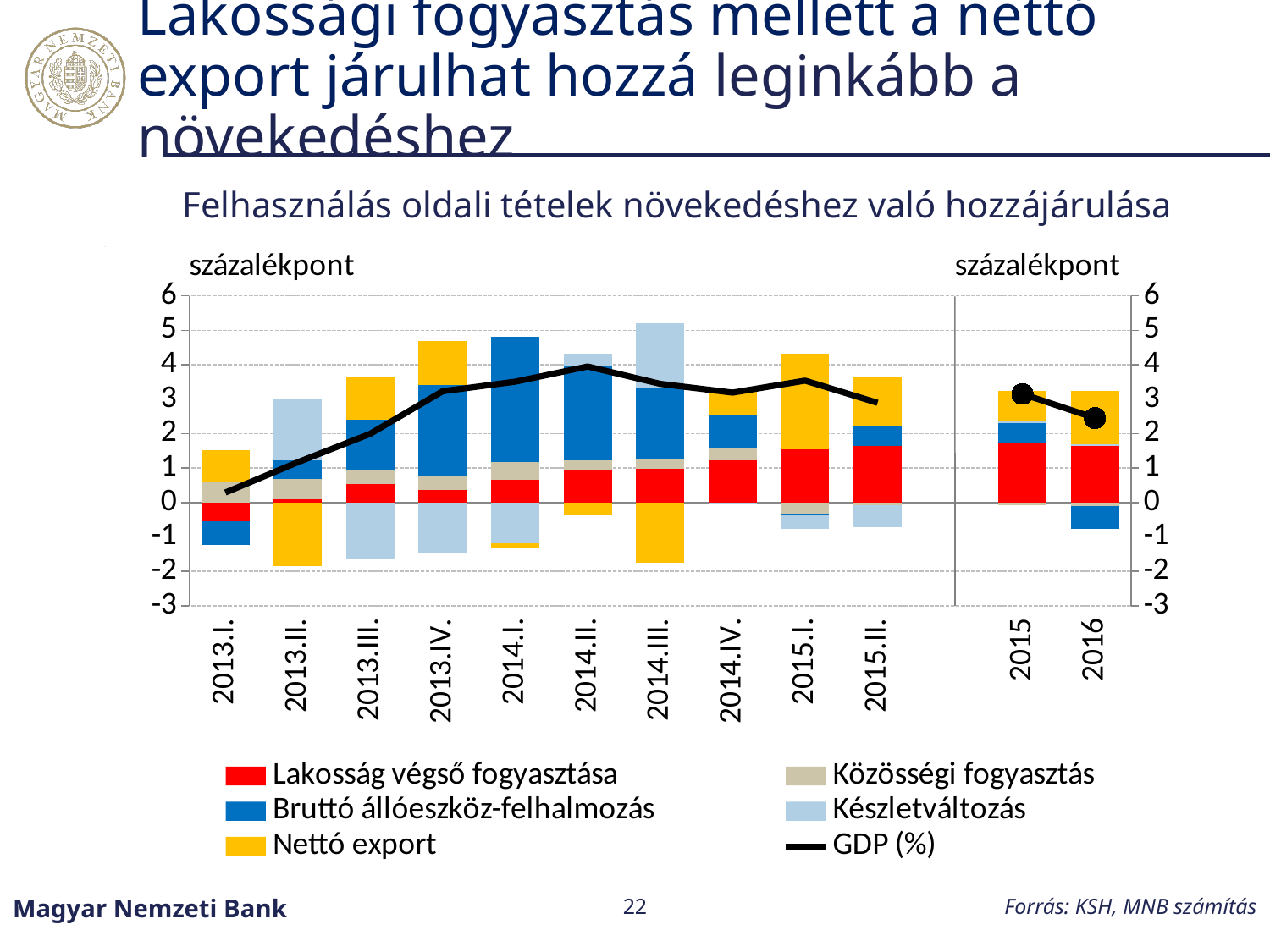
How many categories (periods) are shown on the x axis? 12 What is the title of the chart? Felhasználás oldali tételek növekedéshez való hozzájárulása Does the GDP (%) line rise or fall from 2013.I. to 2014.II.? rise Does the GDP (%) line rise or fall from 2015 to 2016? fall In which period does the GDP (%) line reach its highest value? 2014.II. Is the GDP (%) value for 2013.I. greater or less than 1? less Is the GDP (%) value for 2014.II. greater or less than 3? greater What kind of chart is shown on the slide? Stacked bar chart with a line Is the GDP (%) value for 2016 greater or less than 3? less Which is larger, the Lakosság végső fogyasztása contribution in 2015 or in 2013.I.? 2015 How many series does the legend list? 6 In which period is the GDP (%) line at its lowest value? 2013.I.